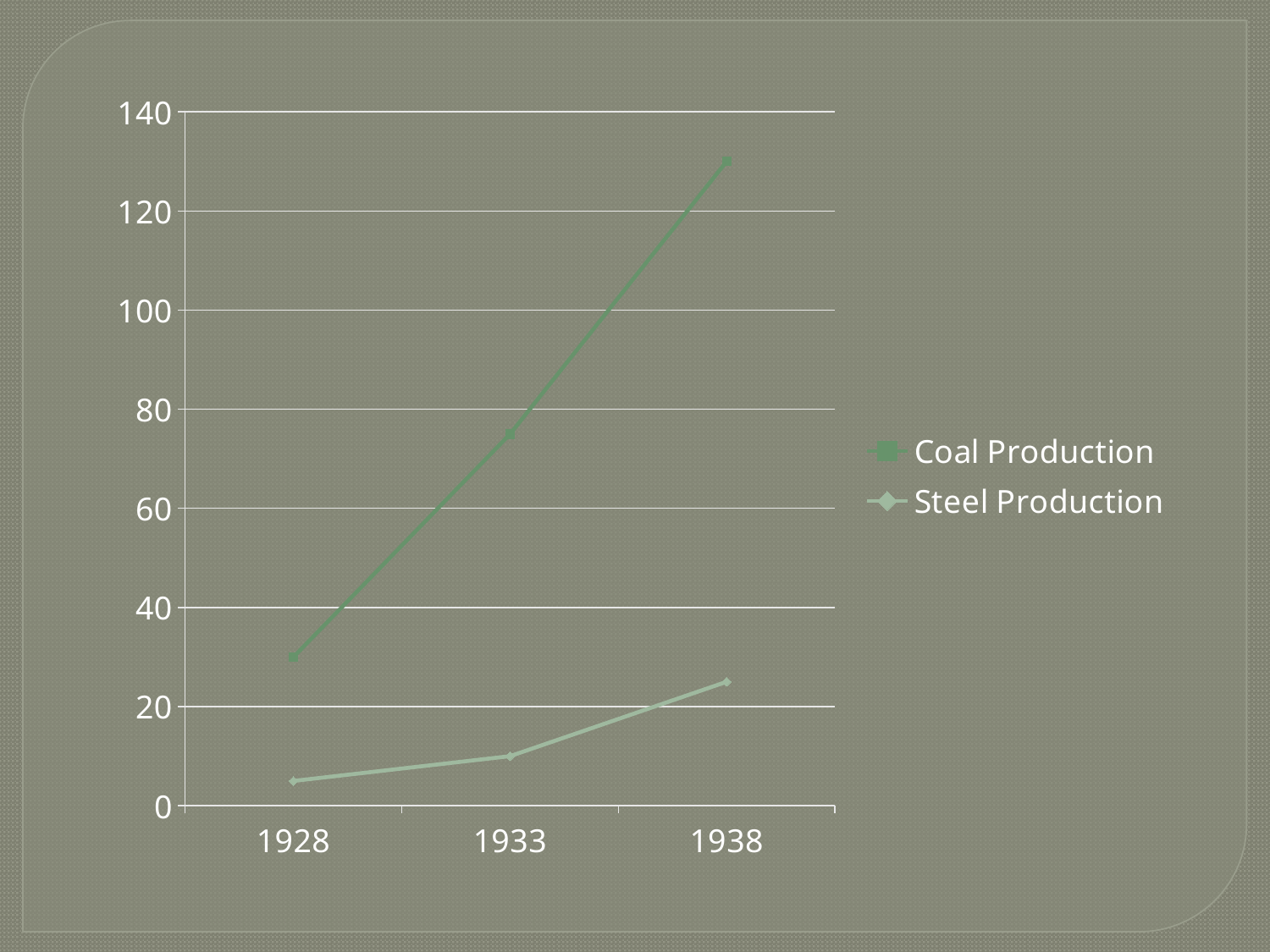
What kind of chart is shown on the slide? line chart In which year is Coal Production highest? 1938 Is the value for Steel Production in 1928 greater or less than 20? less Is the value for Coal Production in 1928 greater or less than 40? less How many series does the legend list? 2 Is the value for Coal Production in 1933 greater or less than 60? greater Do the Steel Production values rise or fall from 1928 to 1938? rise Which series does the legend list first? Coal Production In 1938, which series has the larger value, Coal Production or Steel Production? Coal Production How many years are plotted along the x axis? 3